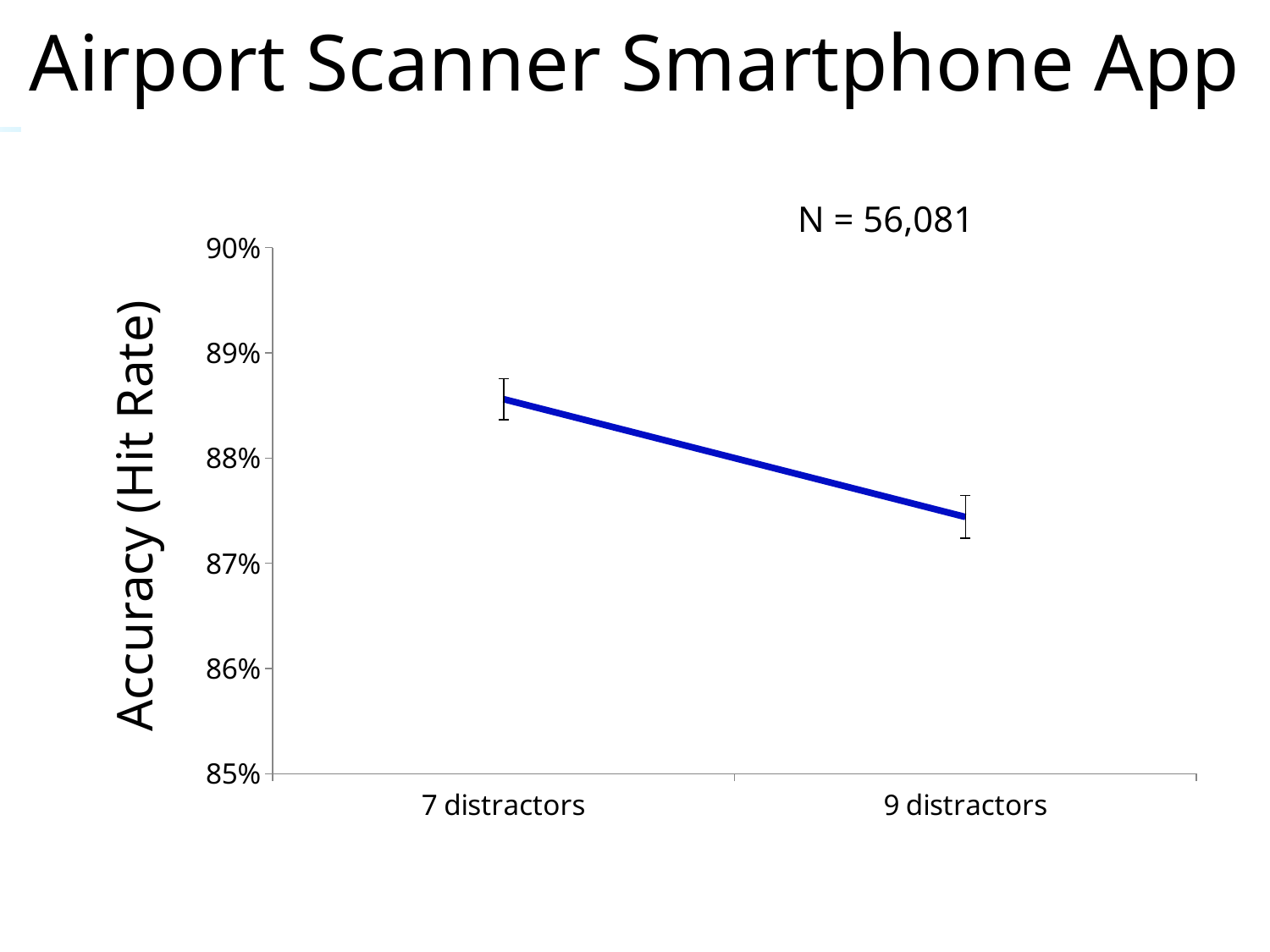
How many categories are plotted on the x axis? 2 Which category has the highest accuracy (hit rate)? 7 distractors Do the accuracy values rise or fall from 7 distractors to 9 distractors? fall Is the accuracy for 7 distractors greater or less than 89%? less What sample size (N) is stated on the chart? N = 56,081 What kind of chart is shown on the slide? line chart Which has a higher accuracy, 7 distractors or 9 distractors? 7 distractors Is the accuracy for 9 distractors greater or less than 88%? less Which category has the lowest accuracy (hit rate)? 9 distractors Is the accuracy for 7 distractors greater or less than 88%? greater What is the label of the y axis? Accuracy (Hit Rate)